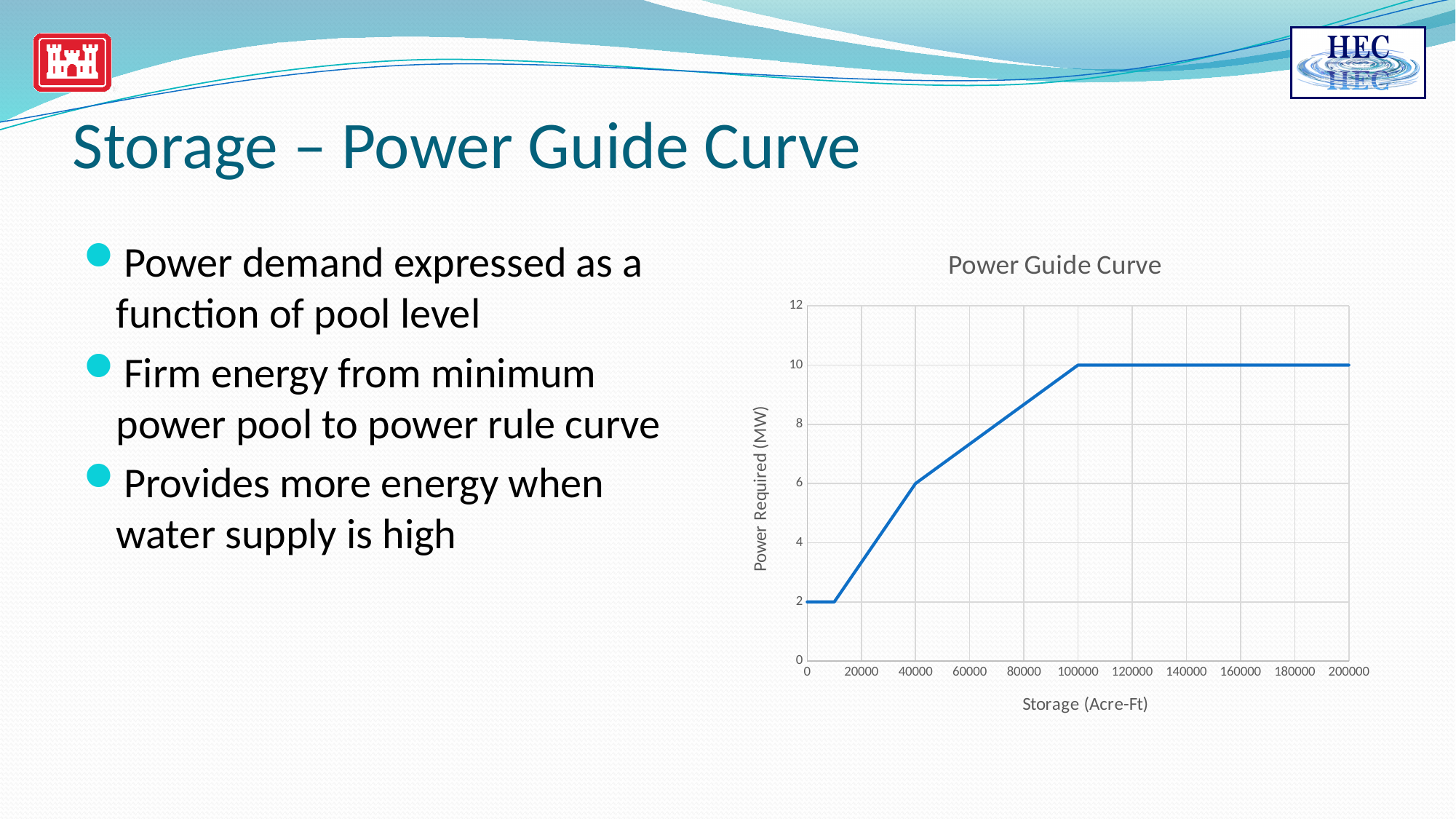
Is the power required at a storage of 20000 acre-ft greater or less than 4 MW? less What type of chart is shown on the slide? line chart What is the power required (MW) when storage is 200000 acre-ft? 10 What is the highest power required value reached by the curve? 10 What is the label of the x axis of the chart? Storage (Acre-Ft) How does the power required change as storage increases from 40000 to 100000 acre-ft? it rises What is the power required (MW) when storage is 40000 acre-ft? 6 What is the power required (MW) when storage is 0 acre-ft? 2 What is the title of the chart? Power Guide Curve Is the power required at a storage of 60000 acre-ft greater or less than 6 MW? greater What is the power required (MW) when storage is 100000 acre-ft? 10 What is the lowest power required value on the curve? 2